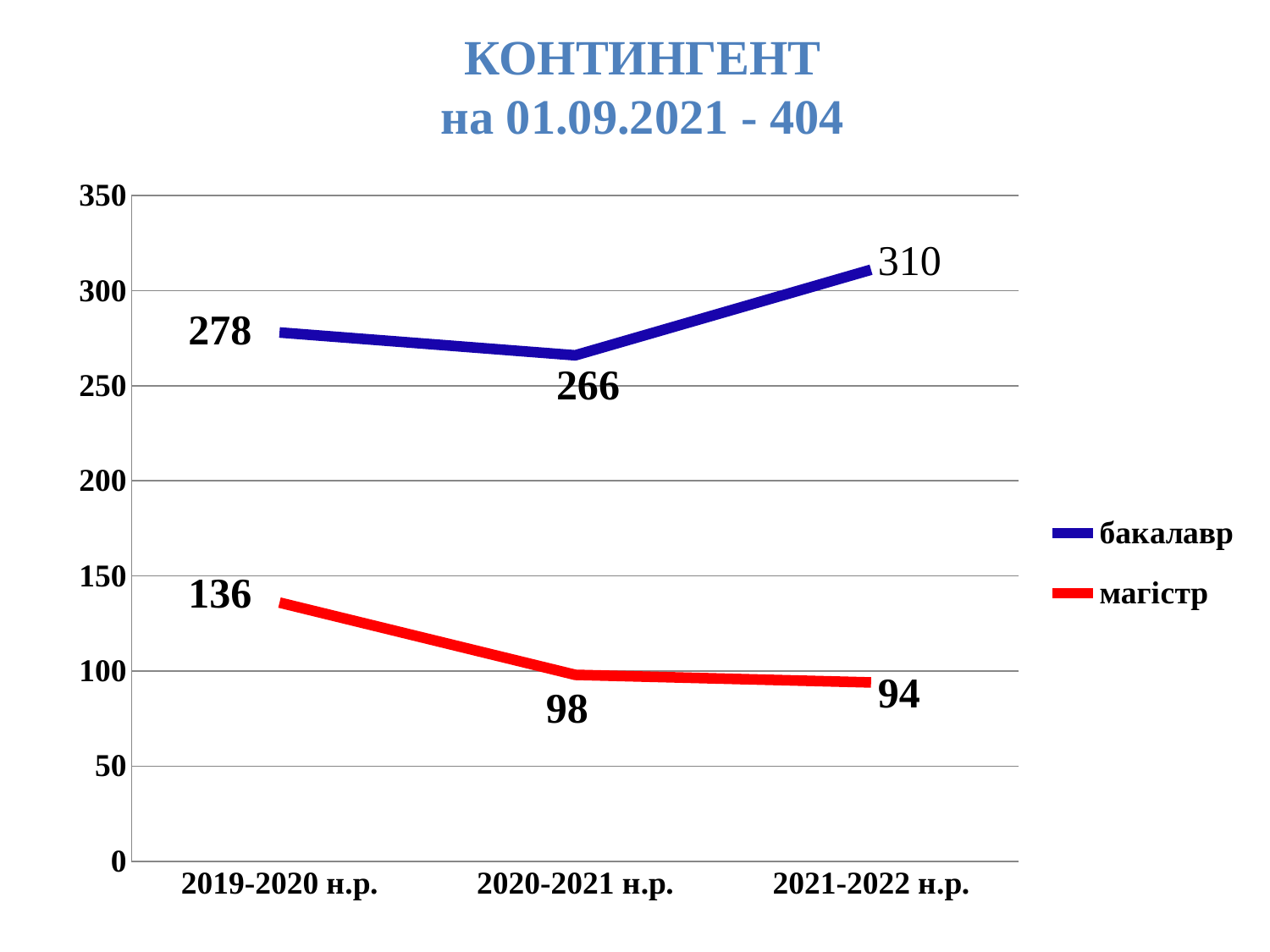
How many series does the legend list? 2 Does the магістр series rise or fall from 2019-2020 н.р. to 2021-2022 н.р.? fall What is the value for бакалавр in 2021-2022 н.р.? 310 How many academic years are shown on the x axis? 3 In which academic year is the бакалавр value highest? 2021-2022 н.р. What is the value for бакалавр in 2019-2020 н.р.? 278 In which academic year is the магістр value lowest? 2021-2022 н.р. What is the difference between the бакалавр and магістр values in 2019-2020 н.р.? 142 Which is larger: бакалавр in 2020-2021 н.р. or бакалавр in 2019-2020 н.р.? бакалавр in 2019-2020 н.р. What kind of chart is shown on the slide? line chart What is the value for магістр in 2020-2021 н.р.? 98 What is the value for магістр in 2021-2022 н.р.? 94